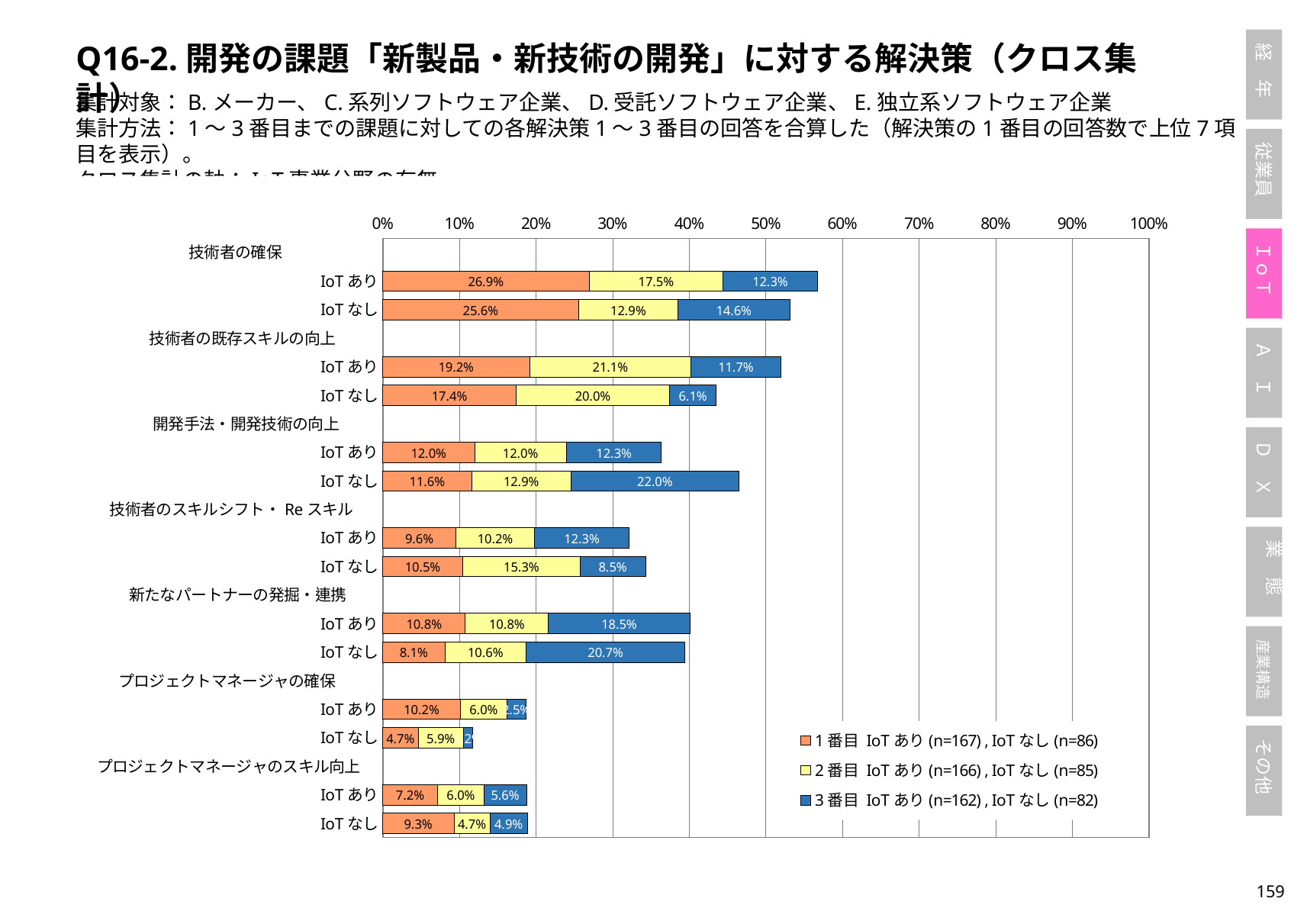
What is the 3番目 value for IoTなし under 開発手法・開発技術の向上? 22.0% Under 新たなパートナーの発掘・連携, which has the larger 3番目 value, IoTあり or IoTなし? IoTなし How many solution categories (excluding the IoTあり/IoTなし sub-rows) are shown on the chart? 7 What is the total of the stacked bar for IoTあり under 技術者の確保? 56.7% What is the difference between the 2番目 values for IoTあり and IoTなし under 技術者の既存スキルの向上? 1.1 percentage points According to the legend, what is the n for IoTあり in the 1番目 series? n=167 What is the 2番目 value for IoTなし under 技術者のスキルシフト・Reスキル? 15.3% How many series does the legend list? 3 Is the total length of the IoTなし bar under 技術者の確保 greater or less than 50%? greater Which solution category has the highest 1番目 value for IoTあり? 技術者の確保 What is the 1番目 value for IoTあり under 技術者の確保? 26.9% What kind of chart is shown on the slide? Stacked horizontal bar chart